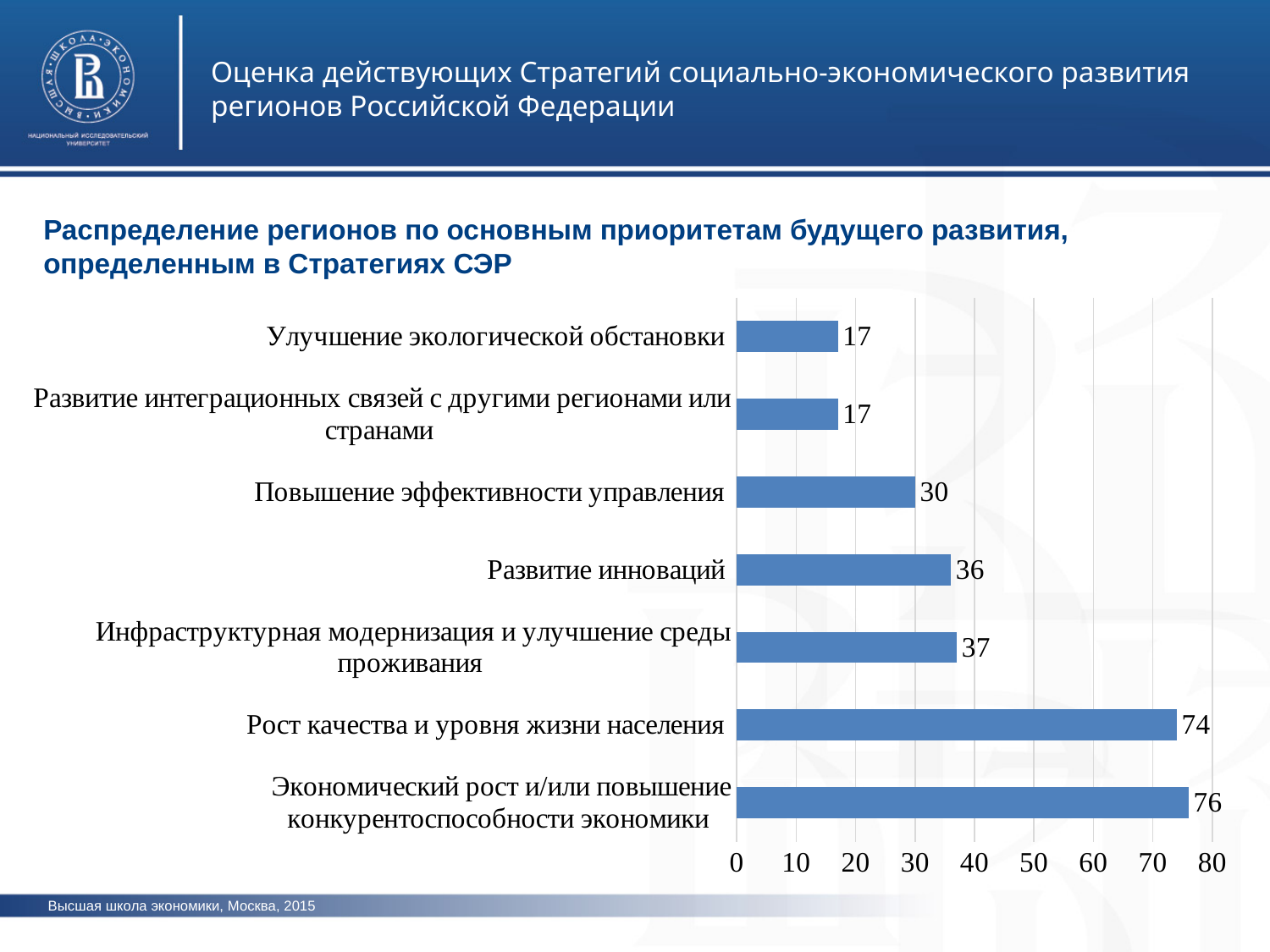
Which category has the highest value? Экономический рост и/или повышение конкурентоспособности экономики What value is shown for «Рост качества и уровня жизни населения»? 74 How many categories have a value of 17? 2 What is the difference between the values for «Экономический рост и/или повышение конкурентоспособности экономики» and «Рост качества и уровня жизни населения»? 2 Is the value for «Рост качества и уровня жизни населения» greater or less than 70? greater What value is shown for «Развитие инноваций»? 36 What kind of chart is shown on the slide? bar chart What value is shown for «Повышение эффективности управления»? 30 How many categories are shown in the chart? 7 Which is larger: the value for «Повышение эффективности управления» or the value for «Развитие инноваций»? Развитие инноваций What is the maximum value shown on the horizontal axis? 80 What is the difference between the values for «Инфраструктурная модернизация и улучшение среды проживания» and «Улучшение экологической обстановки»? 20